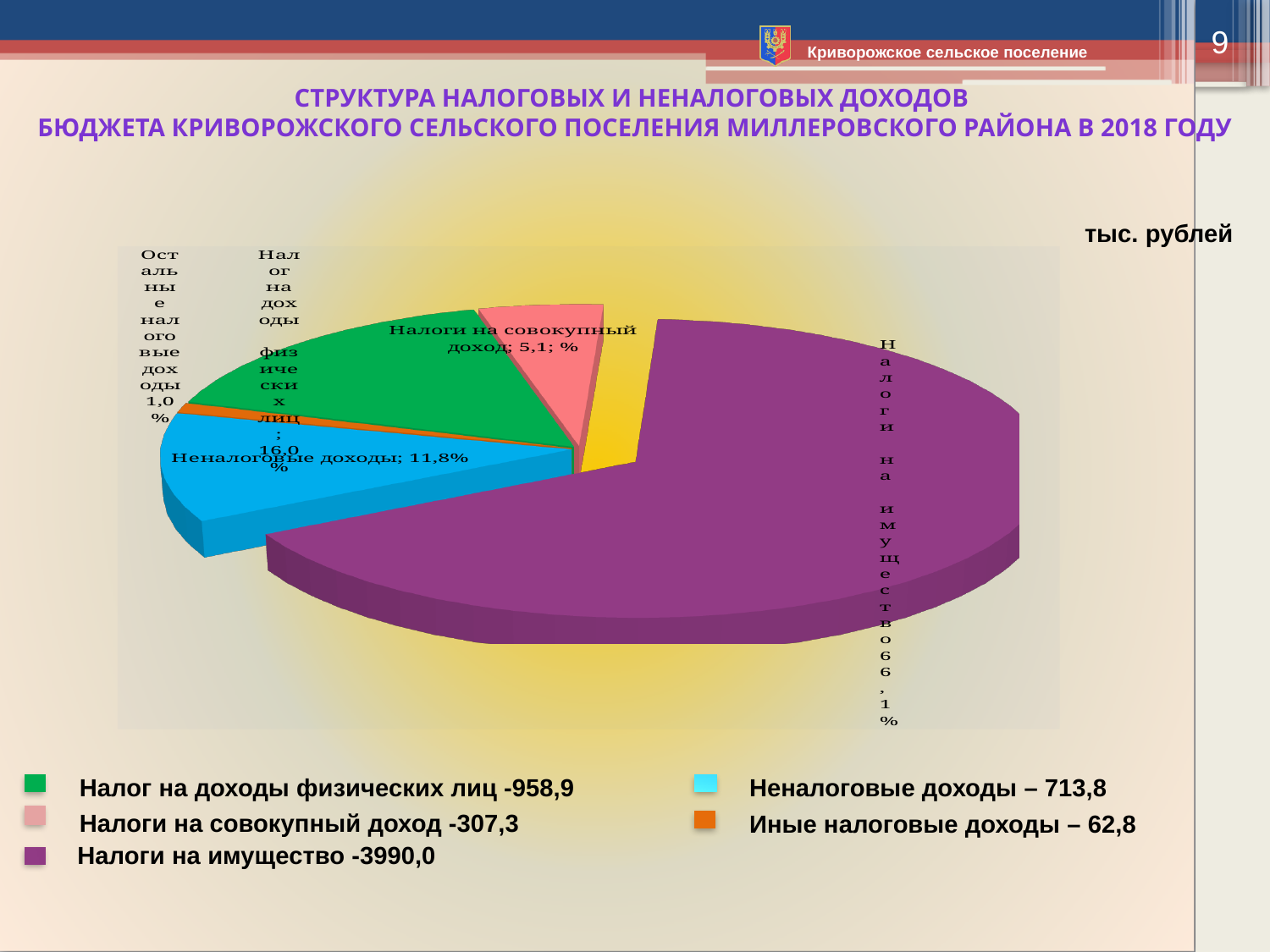
What kind of chart is shown on the slide? pie chart What share of the pie does Налоги на совокупный доход have? 5,1% Which category has the largest slice of the pie? Налоги на имущество How many slices does the pie chart have? 5 According to the legend, what is the value for Налоги на имущество? 3990,0 What share of the pie does Налоги на имущество have? 66,1% What share of the pie does Неналоговые доходы have? 11,8% Which category has the smallest slice of the pie? Остальные налоговые доходы What unit is stated for the values on the slide? тыс. рублей According to the legend, what is the value for Налог на доходы физических лиц? 958,9 Which is larger, Неналоговые доходы or Налоги на совокупный доход? Неналоговые доходы